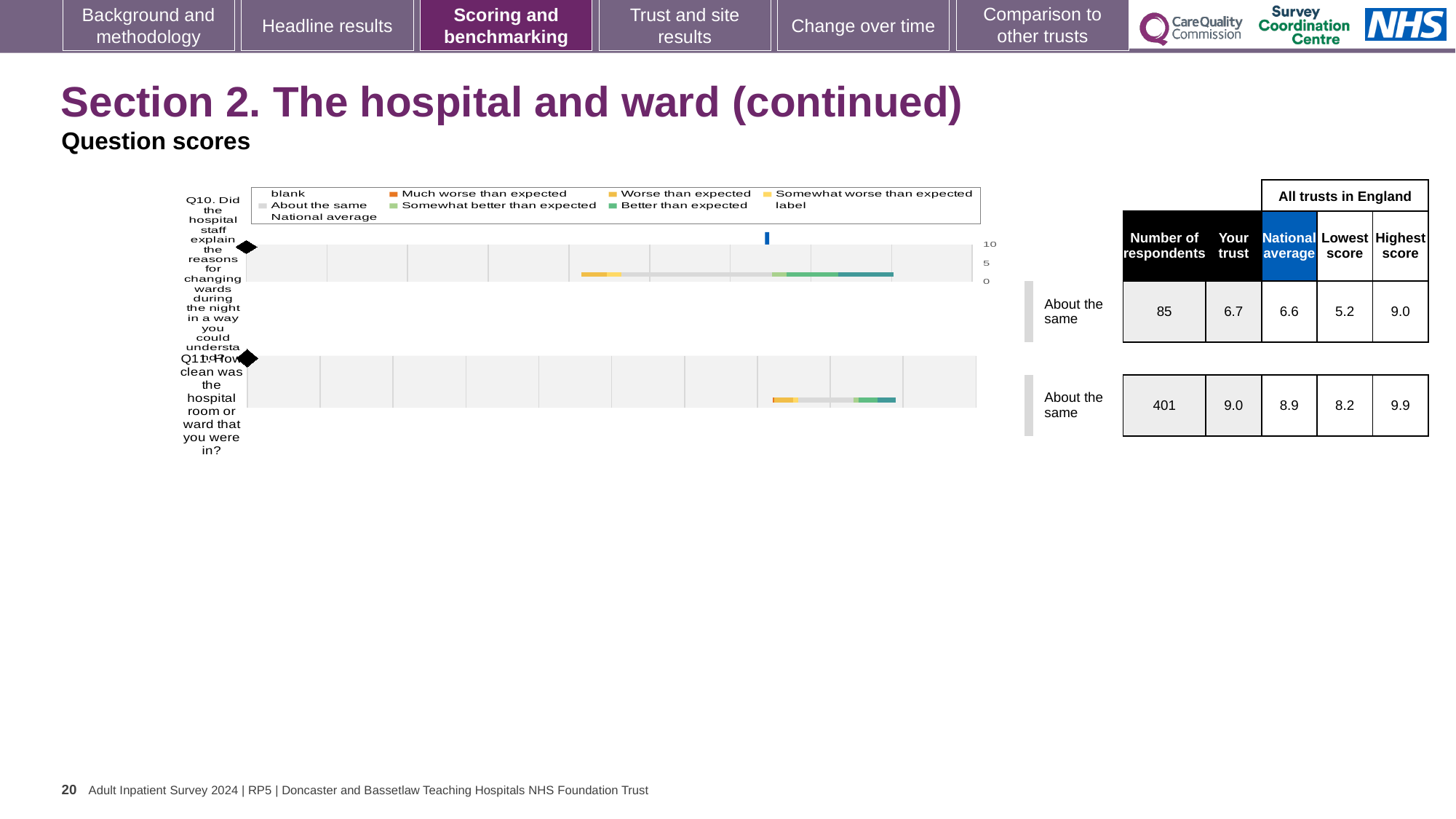
What is the 'Your trust' score for Q10? 6.7 What benchmark rating is given for Q10 (Did the hospital staff explain the reasons for changing wards during the night)? About the same What benchmark rating is given for Q11 (How clean was the hospital room or ward)? About the same What is the difference between the 'Your trust' scores for Q11 and Q10? 2.3 How many questions (categories) are plotted on the slide? 2 What is the maximum value shown on the score axis of the Q10 chart? 10 Which legend entry is shown in orange in the chart legend? Much worse than expected How many respondents answered Q11? 401 What kind of chart is used to show the Q10 and Q11 question scores? bar chart What is the national average score for Q10? 6.6 What is the 'Your trust' score for Q11? 9.0 Which question has the higher 'Your trust' score, Q10 or Q11? Q11